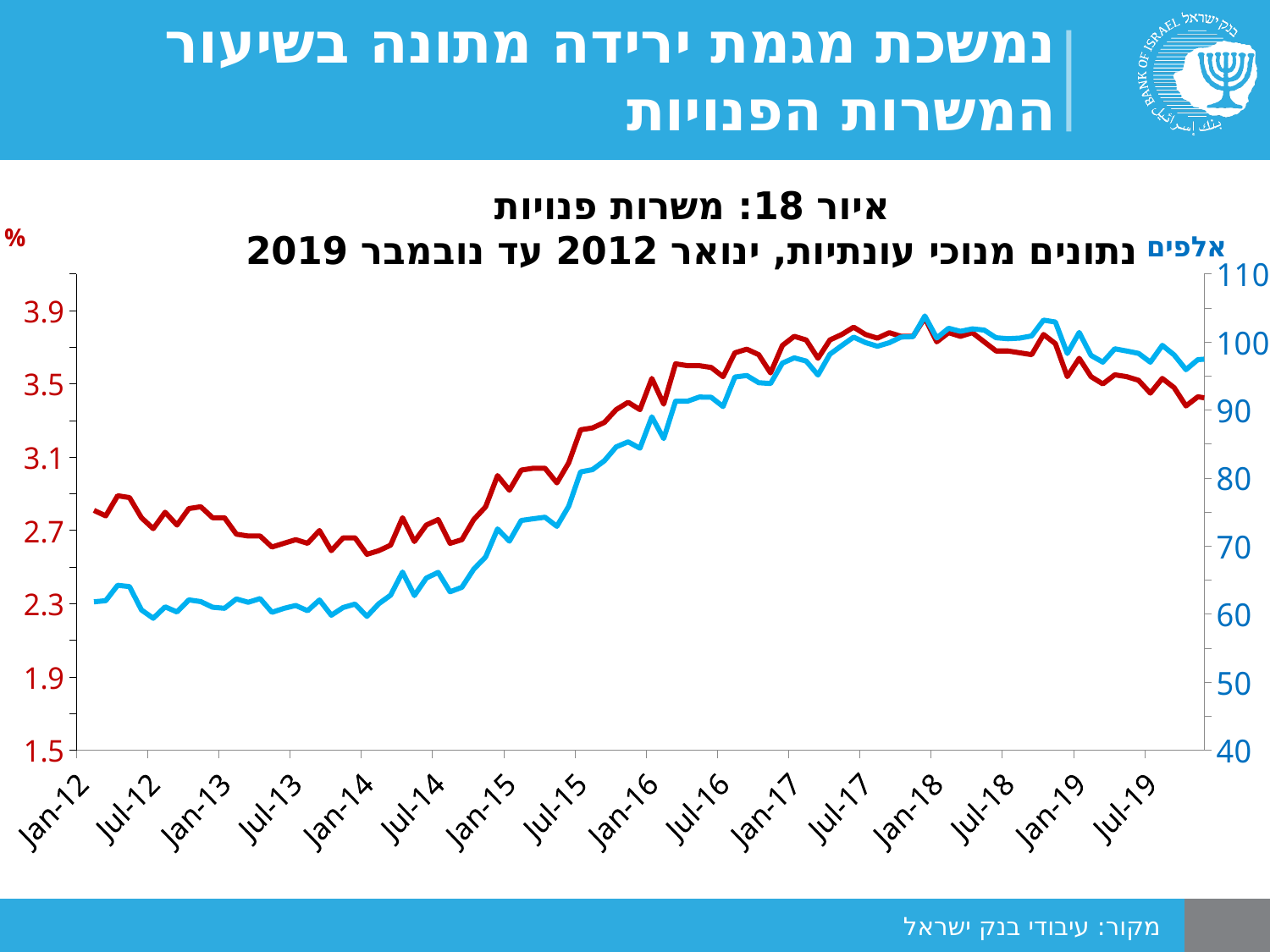
How many date labels are shown on the x axis? 16 Does the red line rise or fall between Jan-18 and Jul-19? fall Is the value of the red line at Jan-18 greater or less than 3.5? greater Is the value of the blue line at Jan-18 greater or less than 100? greater How many lines are plotted on the chart? 2 Does the blue line rise or fall between Jan-14 and Jan-17? rise Is the value of the blue line at Jul-16 greater or less than 90? greater What is the title of the chart? איור 18: משרות פנויות What kind of chart is shown on the slide? line chart What unit is shown at the top of the left vertical axis? %